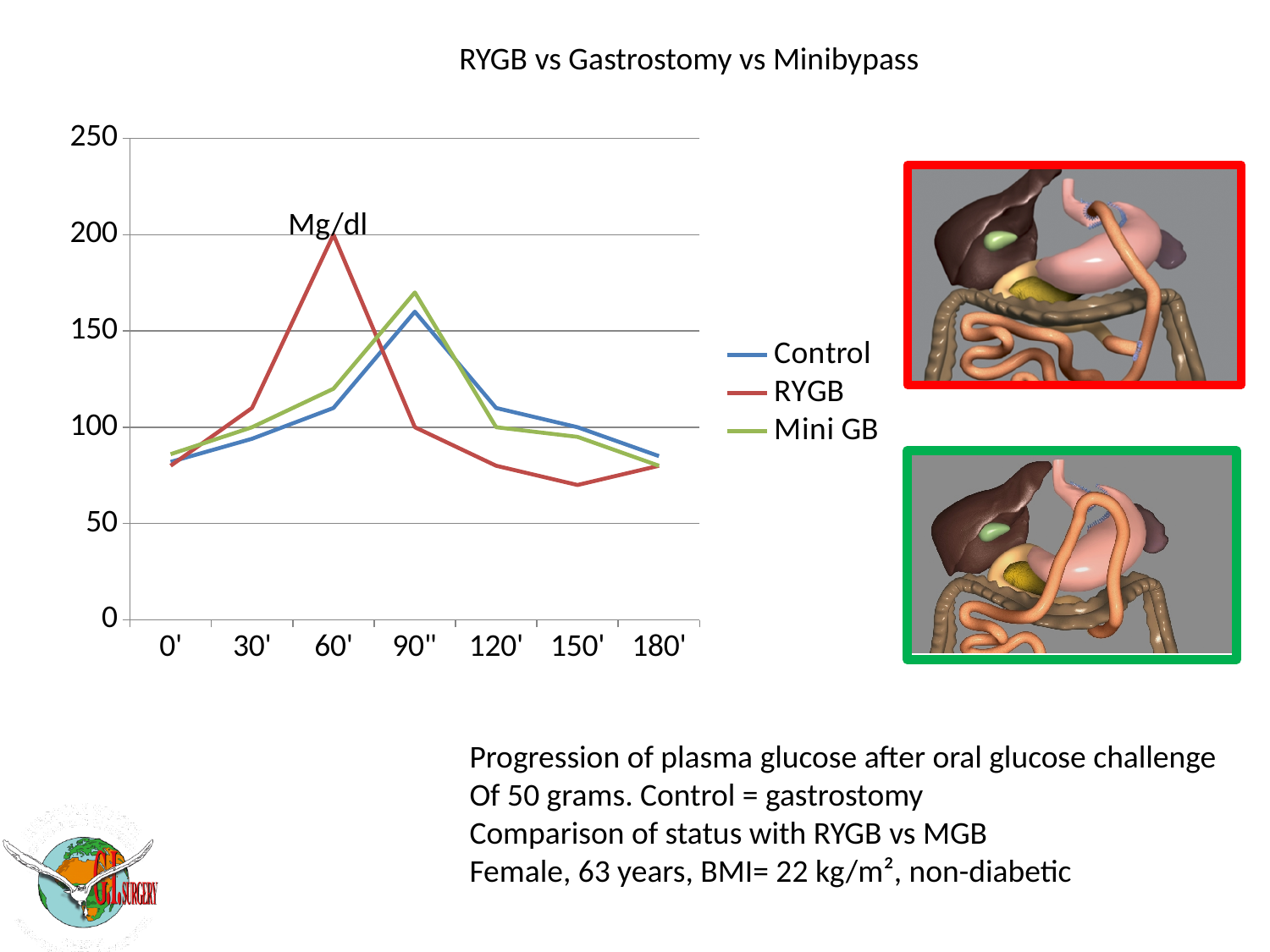
Is the value for Control at 90'' greater or less than 150? greater What unit label is shown on the chart for the plotted values? Mg/dl Which series reaches the highest value on the chart? RYGB Does the RYGB series rise or fall between 60' and 150'? fall How many time points are plotted along the x axis? 7 Is the value for Mini GB at 60' greater or less than 100? greater At which time point does the RYGB series reach its peak? 60' At 60', which series has the larger value, RYGB or Control? RYGB What kind of chart is shown on the slide? line chart Is the value for RYGB at 150' greater or less than 100? less How many series does the legend list? 3 What is the title of the chart? RYGB vs Gastrostomy vs Minibypass